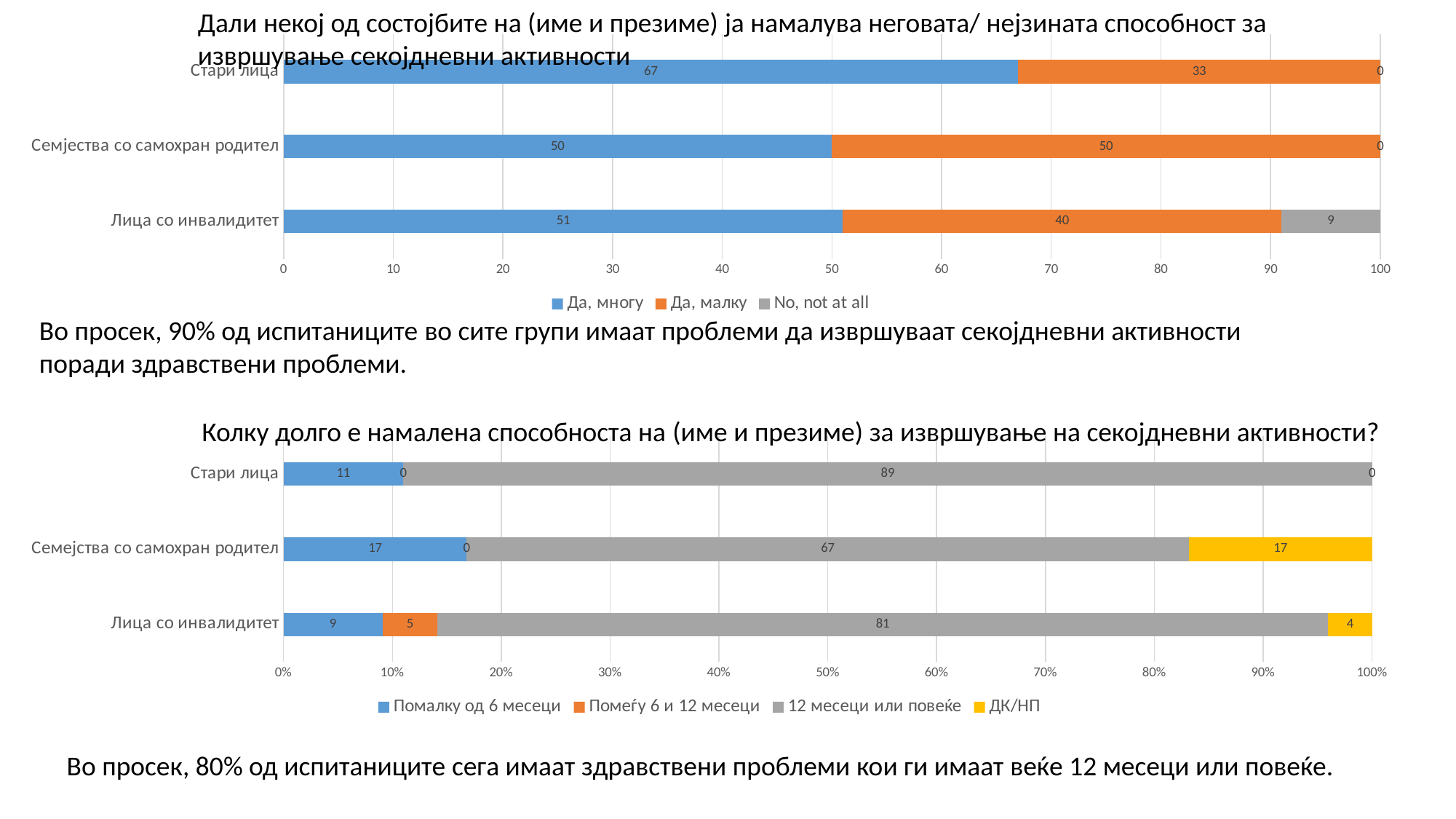
In the bottom chart, which category has the lowest value for "12 месеци или повеќе"? Семејства со самохран родител In the top chart, what is the value of "No, not at all" for "Лица со инвалидитет"? 9 In the top chart, how many series does the legend list? 3 In the bottom chart, is the "Помалку од 6 месеци" value larger for "Семејства со самохран родител" or for "Лица со инвалидитет"? Семејства со самохран родител In the top chart, what is the difference between the "Да, малку" values for "Семејства со самохран родител" and "Стари лица"? 17 In the top chart, what is the value of "Да, многу" for "Стари лица"? 67 In the bottom chart, how many categories are shown on the vertical axis? 3 In the bottom chart, what is the value of "12 месеци или повеќе" for "Стари лица"? 89 What type of chart is the top chart? Stacked bar chart In the top chart, which category has the highest value for "Да, многу"? Стари лица In the bottom chart, what is the value of "ДК/НП" for "Семејства со самохран родител"? 17 In the bottom chart, how many series does the legend list? 4